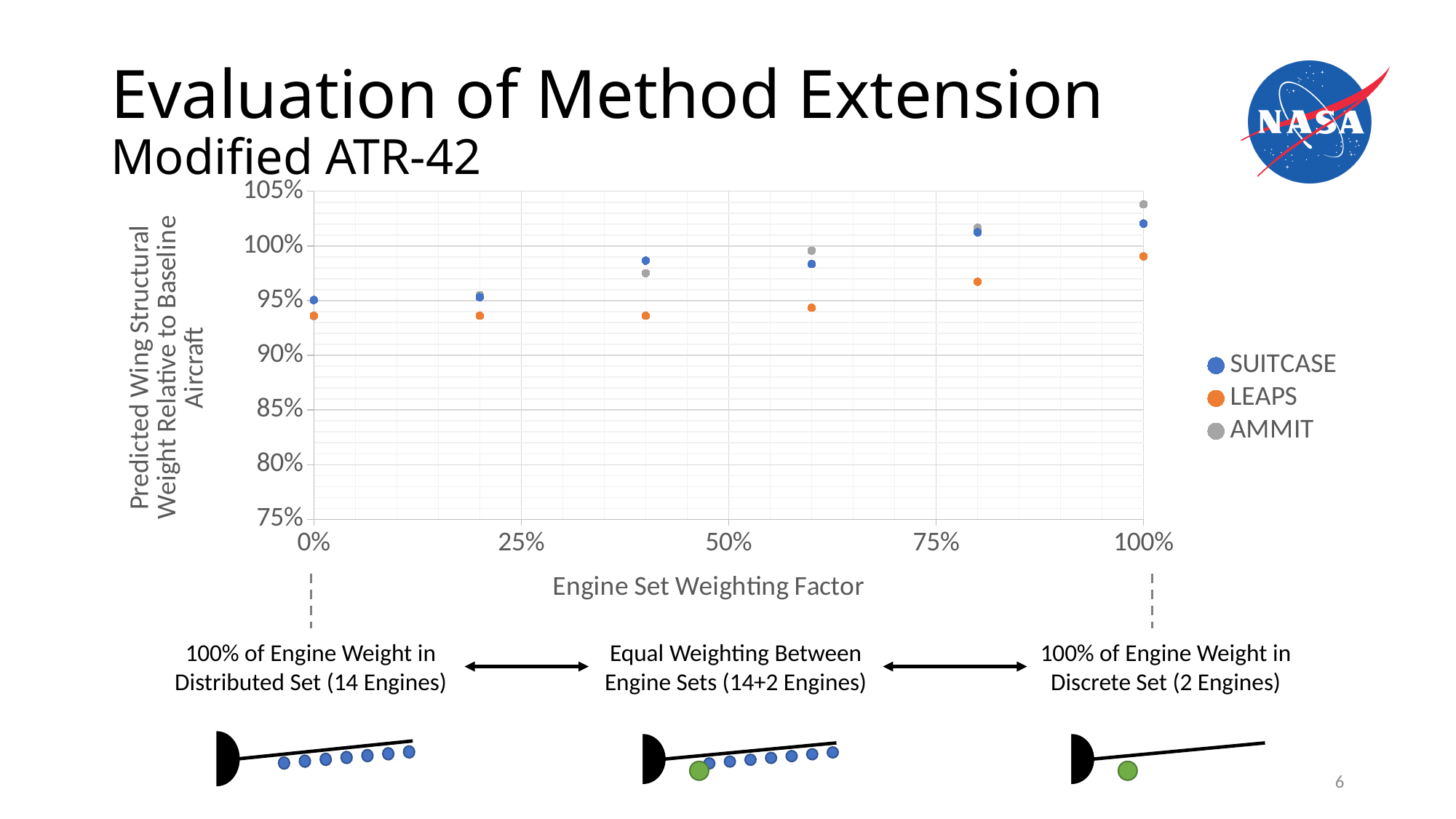
Is the LEAPS value at an Engine Set Weighting Factor of 0% greater or less than 95%? less Which series is shown in orange in the legend? LEAPS How many series does the chart legend list? 3 At an Engine Set Weighting Factor of 100%, which series has the highest predicted wing structural weight? AMMIT How many data points are plotted for the SUITCASE series? 6 Is the LEAPS value at an Engine Set Weighting Factor of 80% greater or less than 100%? less What is the title of the x axis? Engine Set Weighting Factor At an Engine Set Weighting Factor of 100%, which series has the lowest predicted wing structural weight? LEAPS What kind of chart is shown on the slide? Scatter chart Is the SUITCASE value at an Engine Set Weighting Factor of 100% greater or less than 100%? greater Do the LEAPS values rise or fall as the Engine Set Weighting Factor increases from 0% to 100%? rise At an Engine Set Weighting Factor of 40%, which is larger, the SUITCASE value or the LEAPS value? SUITCASE